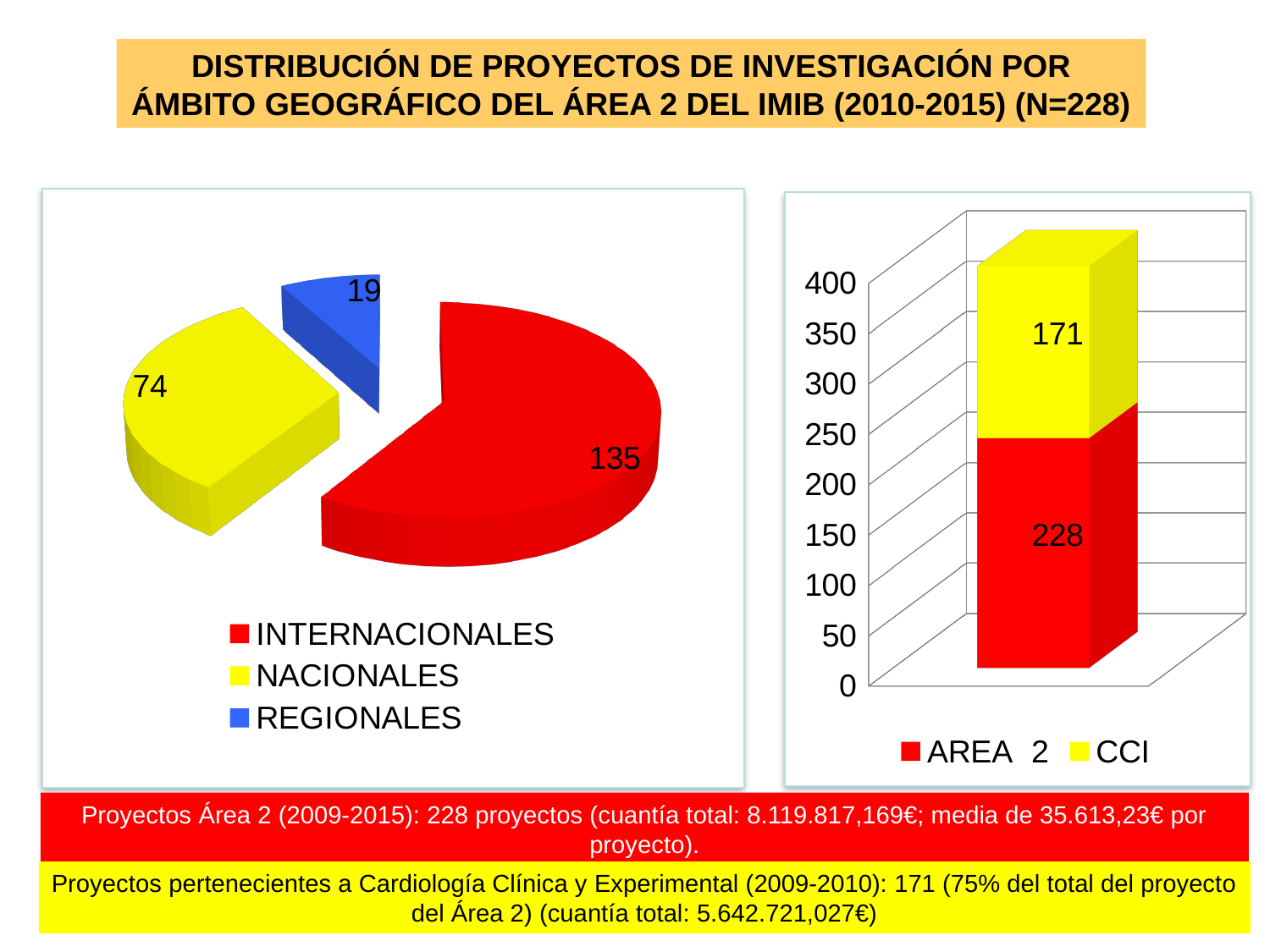
In the pie chart on the left, what is the difference between the INTERNACIONALES and NACIONALES values? 61 How many slices does the pie chart on the left have? 3 How many series does the legend of the chart on the right list? 2 In the pie chart on the left, which category has the largest slice? INTERNACIONALES In the stacked bar chart on the right, what is the value for AREA 2? 228 In the stacked bar chart on the right, what is the total of the stacked bar? 399 What kind of chart is the chart on the left? Pie chart In the stacked bar chart on the right, what is the value for CCI? 171 In the pie chart on the left, what is the value for REGIONALES? 19 In the pie chart on the left, which category has the smallest slice? REGIONALES In the chart on the right, which is larger, the AREA 2 value or the CCI value? AREA 2 In the pie chart on the left, what is the value for NACIONALES? 74